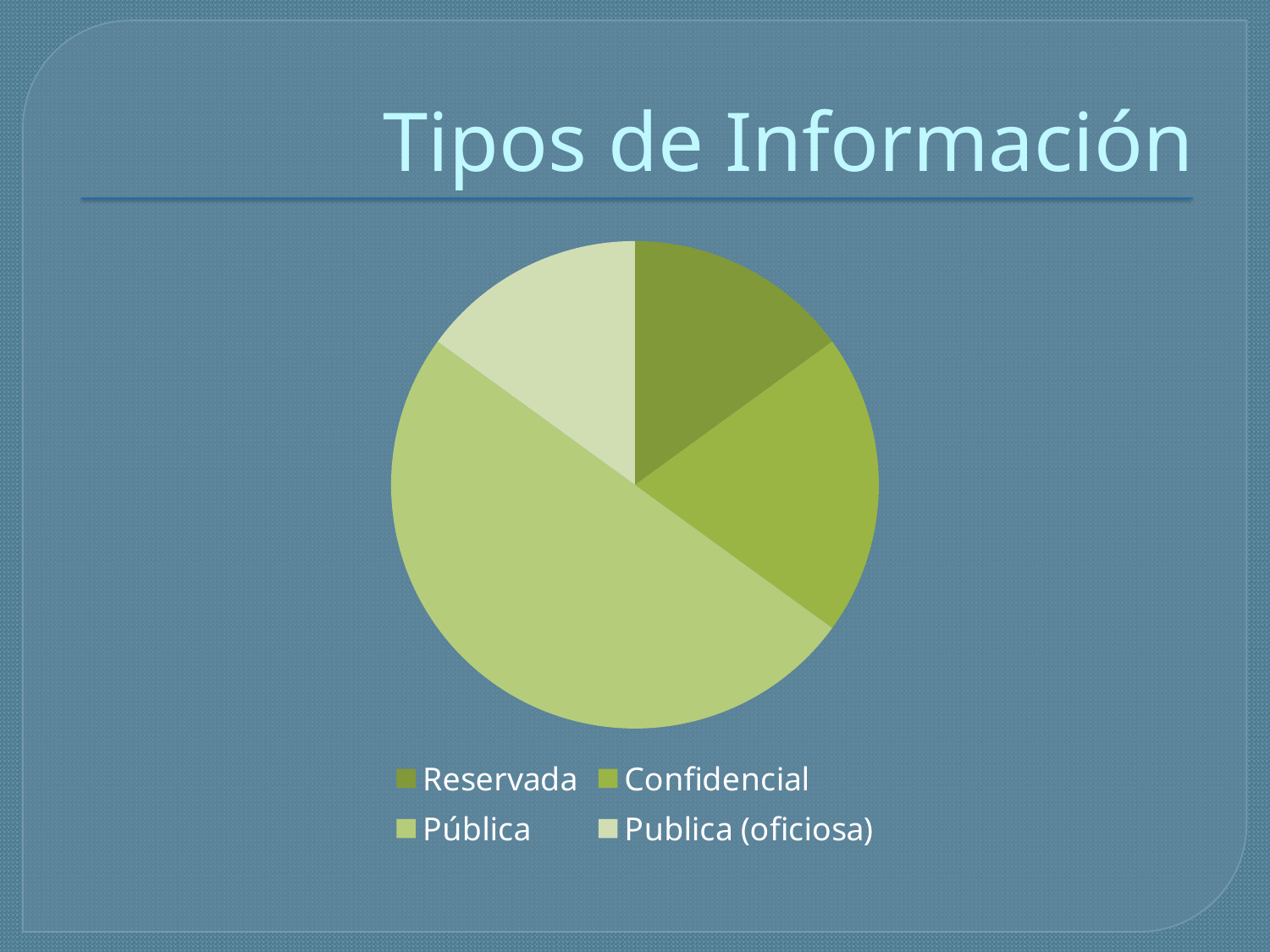
How many slices does the pie chart have? 4 Which slice is larger, Pública or Publica (oficiosa)? Pública Which category has the largest slice of the pie chart? Pública Which slice is larger, Pública or Confidencial? Pública What is the title of the slide containing the pie chart? Tipos de Información Which categories are listed in the legend of the pie chart? Reservada, Confidencial, Pública, Publica (oficiosa) Which slice is larger, Confidencial or Reservada? Confidencial What kind of chart is shown on the slide? pie chart